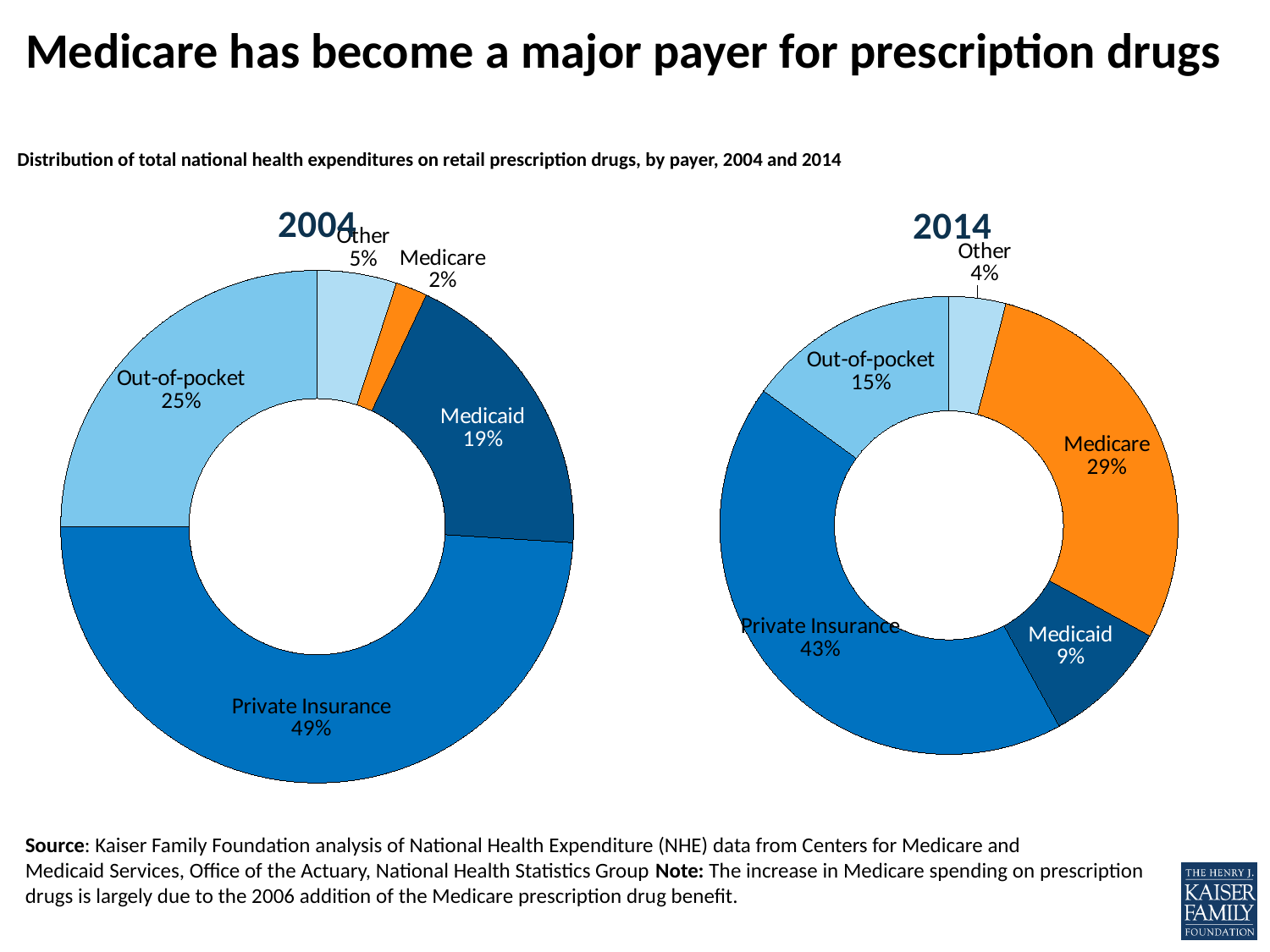
In the 2014 chart, what colour is the Medicare slice? Orange How many percentage points did Medicare's share increase from the 2004 chart to the 2014 chart? 27 In the 2014 chart, what share was paid by Medicaid? 9% In the 2014 chart, which is larger: the Medicare share or the Out-of-pocket share? Medicare In the 2004 chart, which payer has the smallest share? Medicare In the 2004 chart, what share of prescription drug spending was paid by Medicare? 2% In the 2014 chart, what share of prescription drug spending was paid by Medicare? 29% In the 2004 chart, what share was paid out-of-pocket? 25% How many payer categories are shown in the 2014 chart? 5 In the 2004 chart, which payer has the largest share? Private Insurance In the 2014 chart, which payer has the smallest share? Other What type of chart is used to show the 2004 distribution? Donut (pie) chart